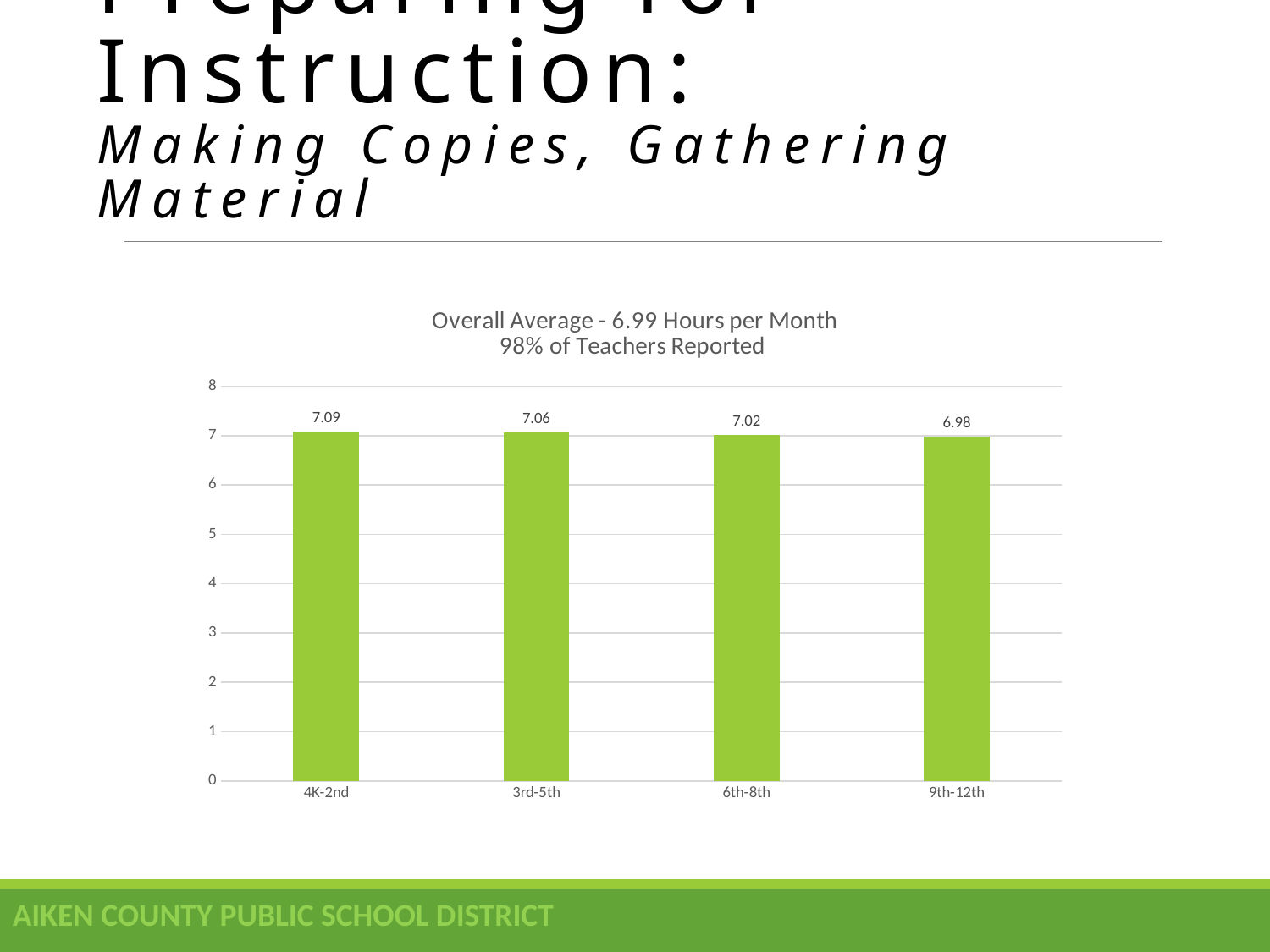
Which grade band has the highest value? 4K-2nd Which is larger, the value for 3rd-5th or the value for 6th-8th? 3rd-5th Do the values rise or fall from 4K-2nd to 9th-12th? fall What is the difference between the values for 4K-2nd and 9th-12th? 0.11 Is the value for 6th-8th greater or less than 6? greater What is the value for 6th-8th? 7.02 What is the value for 9th-12th? 6.98 How many grade bands are shown on the chart? 4 What is the value for 4K-2nd? 7.09 Which grade band has the lowest value? 9th-12th What kind of chart is shown on the slide? bar chart What is the value for 3rd-5th? 7.06